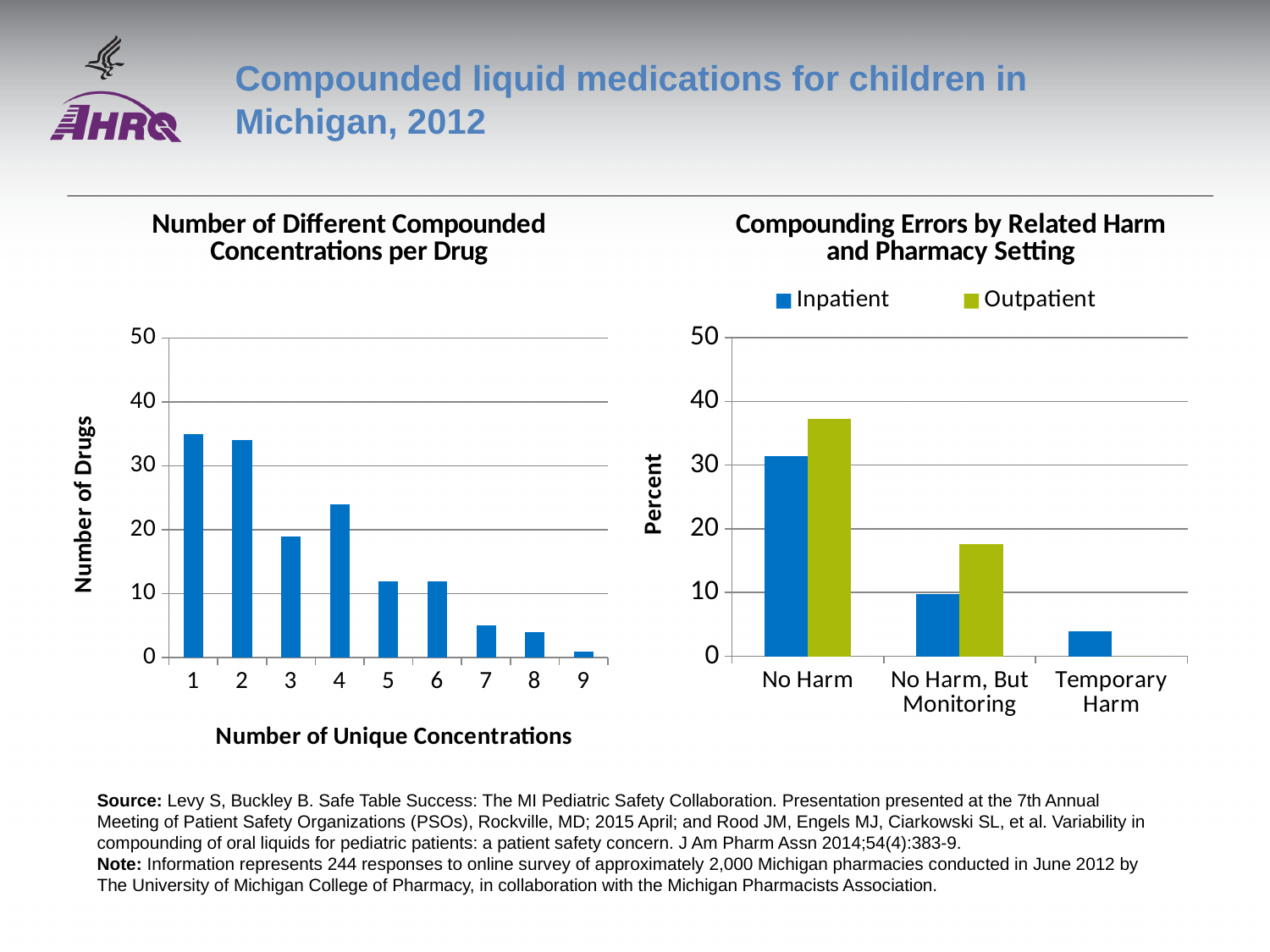
On the right chart (Compounding Errors by Related Harm and Pharmacy Setting), is the Outpatient percent for No Harm greater or less than 30? greater On the right chart (Compounding Errors by Related Harm and Pharmacy Setting), is the Inpatient percent for Temporary Harm greater or less than 10? less On the right chart (Compounding Errors by Related Harm and Pharmacy Setting), which series and category has the highest percent? Outpatient, No Harm On the left chart (Number of Different Compounded Concentrations per Drug), is the number of drugs with 4 unique concentrations greater or less than 20? greater On the left chart (Number of Different Compounded Concentrations per Drug), what is the label of the y axis? Number of Drugs On the left chart (Number of Different Compounded Concentrations per Drug), how many categories are shown on the x axis? 9 On the right chart (Compounding Errors by Related Harm and Pharmacy Setting), how many series does the legend list? 2 On the left chart (Number of Different Compounded Concentrations per Drug), which has more drugs: 3 unique concentrations or 4 unique concentrations? 4 On the left chart (Number of Different Compounded Concentrations per Drug), which number of unique concentrations has the lowest number of drugs? 9 What kind of chart is the right chart (Compounding Errors by Related Harm and Pharmacy Setting)? Bar chart